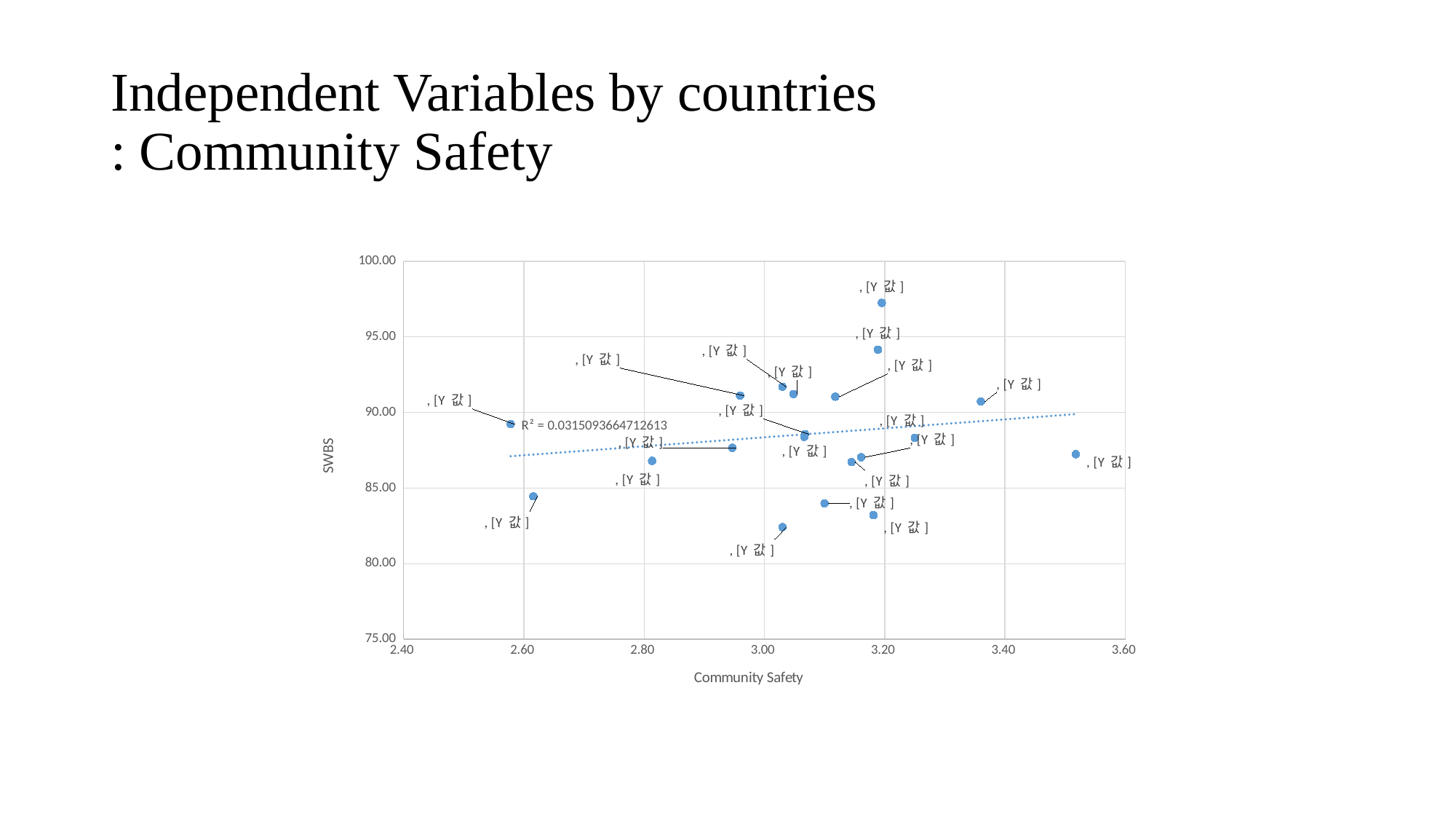
What is the title of the x axis of the chart? Community Safety Is the Community Safety value of the leftmost point greater or less than 2.60? less Does the dotted trendline rise or fall as Community Safety increases? Rise What is the title of the y axis of the chart? SWBS What R² value is printed on the chart? R² = 0.0315093664712613 What kind of chart is shown on the slide? Scatter chart Is the SWBS value of the lowest point on the chart greater or less than 85? less Is the SWBS value of the highest point on the chart greater or less than 95? greater What is the minimum value shown on the x axis? 2.40 What is the maximum value shown on the y axis? 100.00